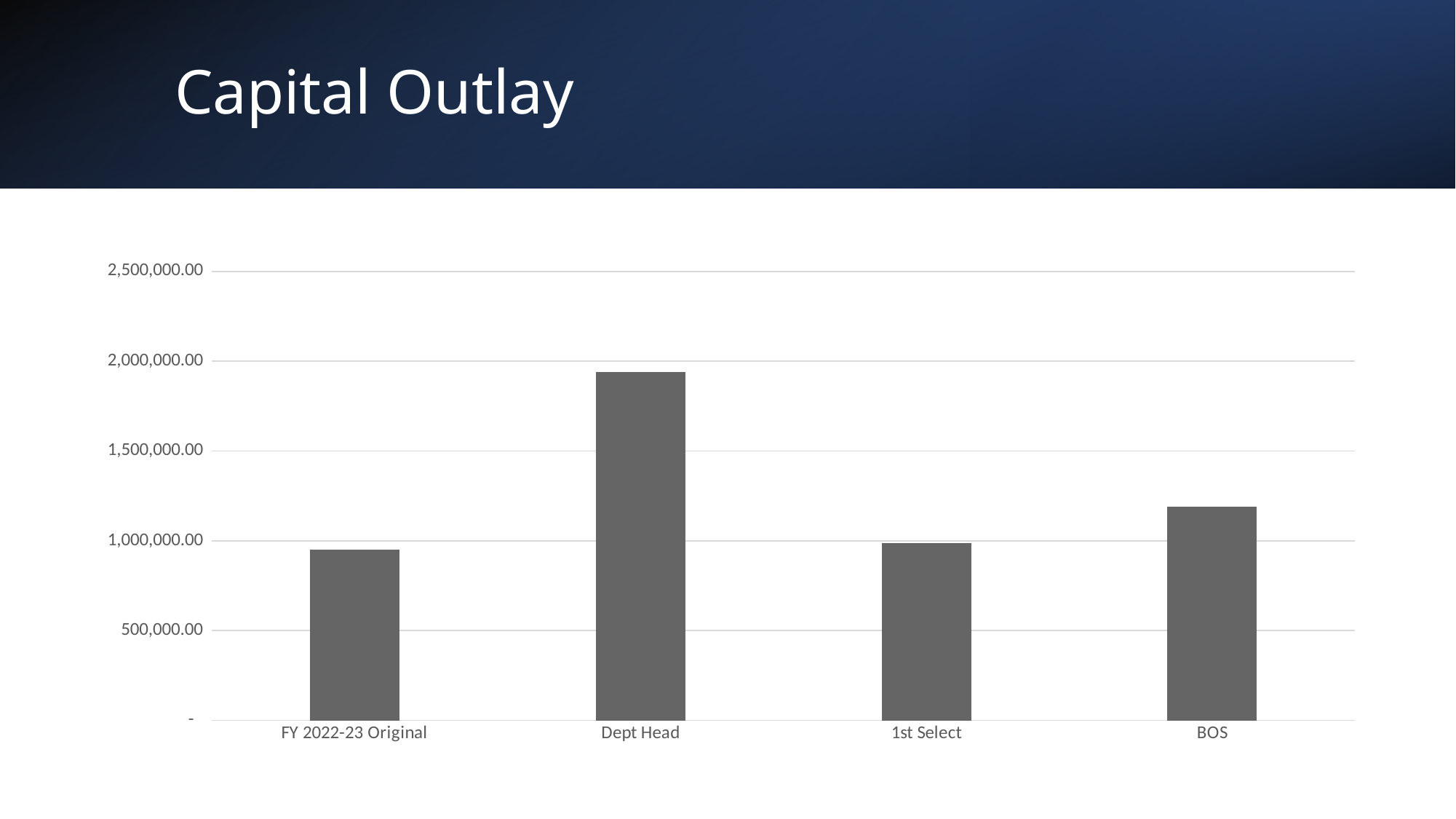
Is the value for 1st Select greater or less than 500,000.00? greater What kind of chart is shown on the slide? bar chart Is the value for BOS greater or less than 1,000,000.00? greater Which category has the highest value on the chart? Dept Head Is the value for Dept Head greater or less than 1,500,000.00? greater What is the title of the slide containing the chart? Capital Outlay Which is larger, the value for Dept Head or the value for BOS? Dept Head How many categories are plotted on the chart? 4 Which is larger, the value for BOS or the value for 1st Select? BOS